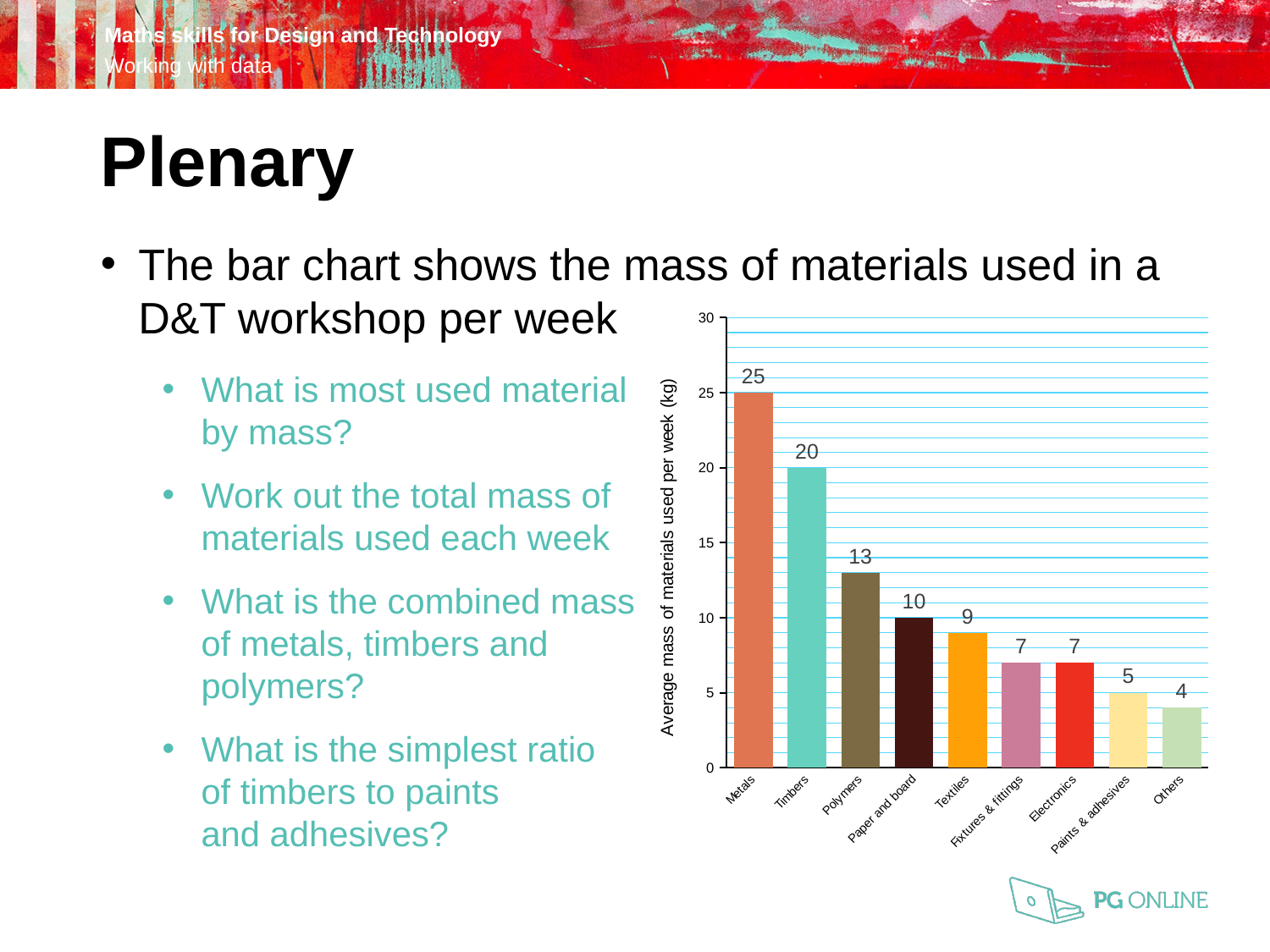
What is the value shown for Polymers? 13 What is the average mass of metals used per week? 25 Which material has the highest average mass used per week? Metals How many material categories are shown on the x axis? 9 What is the difference between the values for Polymers and Paper and board? 3 What is the label on the vertical axis of the chart? Average mass of materials used per week (kg) Is the value for Timbers greater or less than 15? greater What is the value shown for Paints & adhesives? 5 Which is larger, the value for Textiles or the value for Electronics? Textiles Which material has the lowest average mass used per week? Others What is the difference between the values for Metals and Timbers? 5 What kind of chart is shown on the slide? bar chart